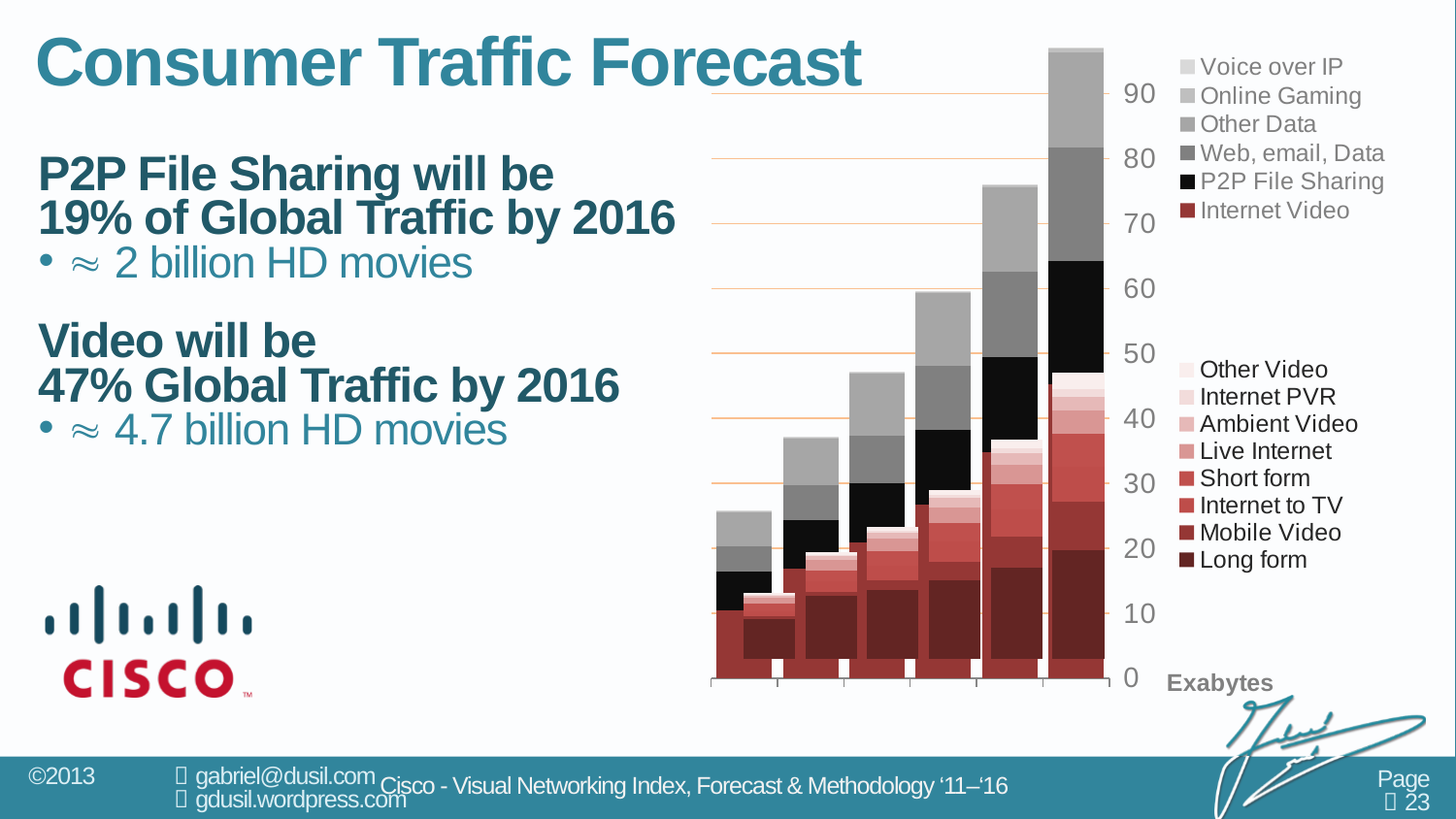
What kind of chart is shown on the slide? Stacked bar chart How many entries does the upper legend (Voice over IP through Internet Video) list? 6 Is the total of the rightmost bar greater or less than 80? greater Is the total of the leftmost bar greater or less than 30? less Which legend entry corresponds to the bottom segment of each bar? Long form How many entries does the lower legend (Other Video through Long form) list? 8 Is the total of the second bar from the left greater or less than 30? greater What unit is the y axis measured in, according to the label below the axis? Exabytes Which bar has the smallest total height? The leftmost bar How many bars does the chart contain? 6 Do the total bar heights rise or fall from left to right along the x axis? Rise Which bar has the greatest total height? The rightmost bar